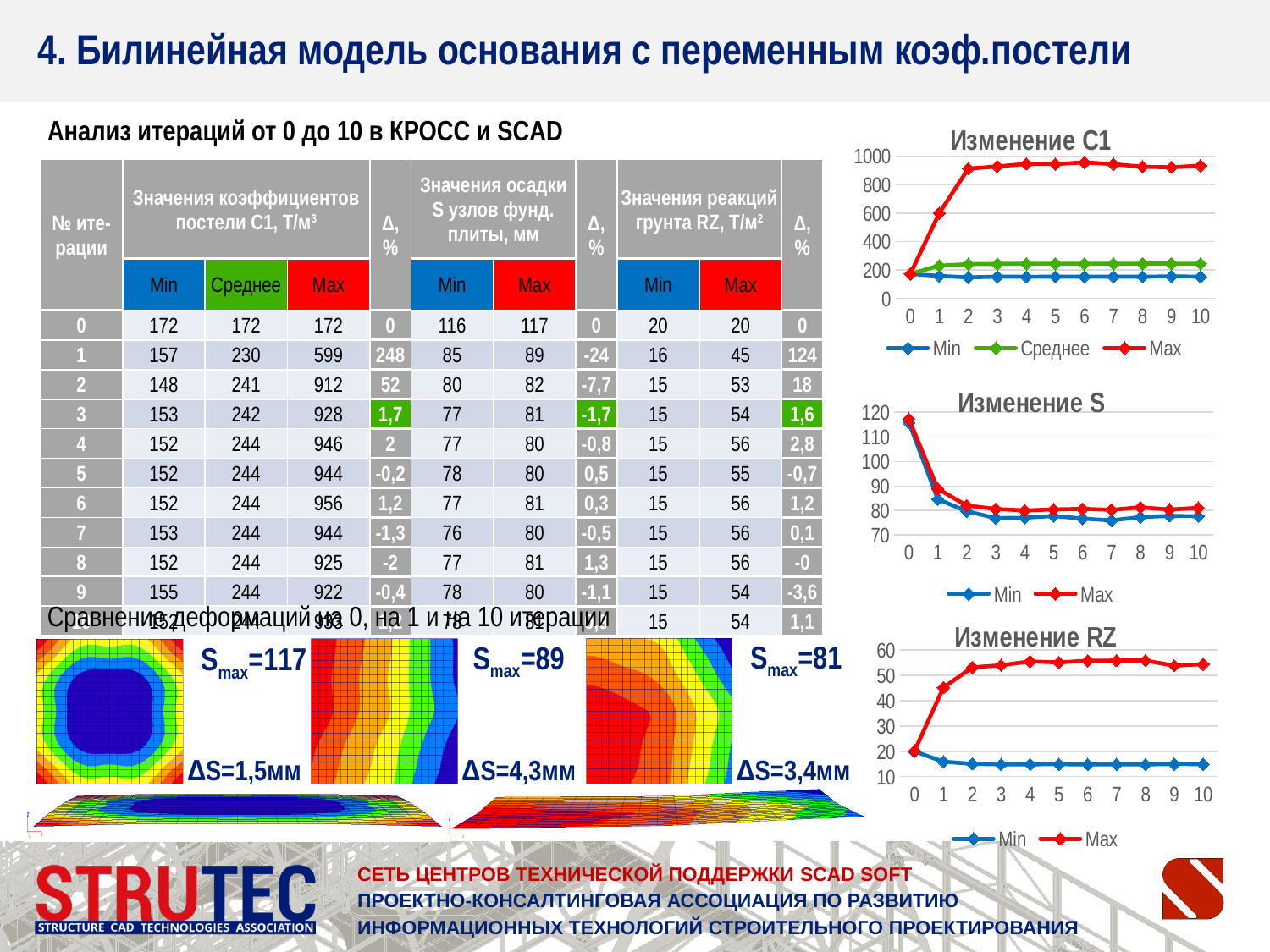
In the "Изменение C1" chart, is the Max value at iteration 5 greater or less than 800? greater In the "Изменение S" chart, is the Max value at iteration 1 greater or less than 100? less In the "Изменение C1" chart, which is larger at iteration 10: Max or Среднее? Max In the "Изменение RZ" chart, what is the Min value at iteration 0? 20 How many series does the legend of the "Изменение RZ" chart list? 2 In the "Изменение C1" chart, is the Min value at iteration 10 greater or less than 200? less In the "Изменение C1" chart, which series has the highest values from iteration 1 onward? Max In the "Изменение S" chart, does the Min series rise or fall from iteration 0 to iteration 3? fall How many series does the legend of the "Изменение C1" chart list? 3 How many iteration points are plotted along the x axis of the "Изменение S" chart? 11 What kind of chart is the "Изменение C1" chart? line chart